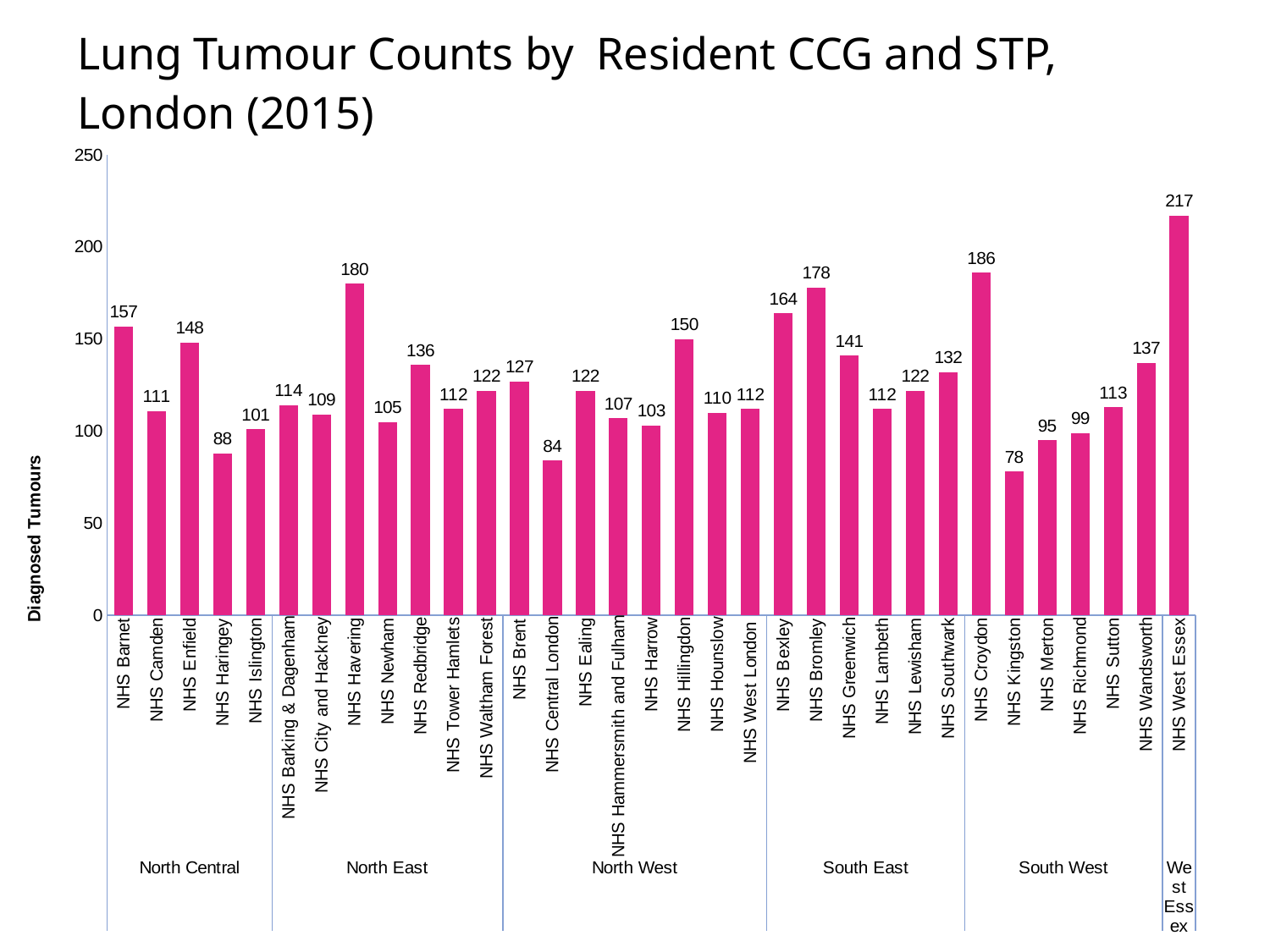
Which has a higher diagnosed tumour count, NHS Barnet or NHS Enfield? NHS Barnet What is the diagnosed tumour count for NHS Croydon? 186 What is the diagnosed tumour count for NHS Havering? 180 How many CCGs are shown on the chart? 33 Which CCG has the highest diagnosed tumour count? NHS West Essex What is the diagnosed tumour count for NHS Central London? 84 Which CCG has the lowest diagnosed tumour count? NHS Kingston Is the value for NHS Hillingdon greater or less than 100? greater What kind of chart is shown on the slide? Bar chart What is the label on the vertical axis? Diagnosed Tumours How many CCGs are grouped under the North East STP? 7 What is the difference between the diagnosed tumour counts for NHS Bromley and NHS Bexley? 14